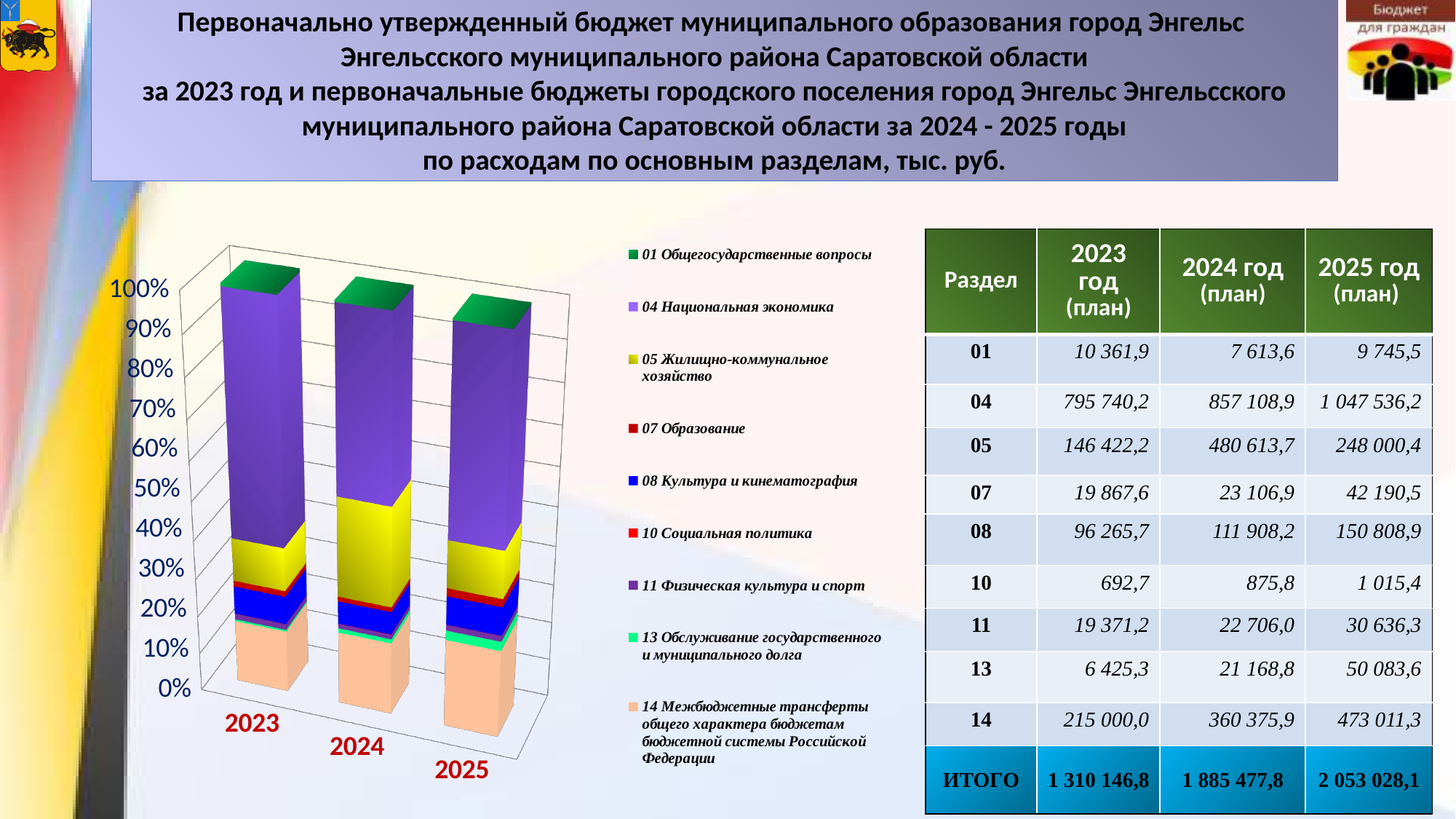
According to the table, which is larger: section 14 in 2024 or section 05 in 2024? section 05 in 2024 What kind of chart is shown on the left of the slide? stacked bar chart According to the table, which section has the lowest planned value in 2025? 10 According to the table, what is the planned value for section 05 in 2024? 480 613,7 How many series does the chart legend list? 9 Which legend entry is shown in yellow on the chart? 05 Жилищно-коммунальное хозяйство According to the table, what is the planned value for section 04 in 2025? 1 047 536,2 How many years (bars) are plotted on the chart? 3 What is the maximum value shown on the chart's vertical axis? 100% In the 2023 bar, is the top of the bottom (14 Межбюджетные трансферты) segment above or below 20%? below According to the table, what is the total (ИТОГО) for 2023? 1 310 146,8 Does the share of the bottom segment (14 Межбюджетные трансферты) rise or fall from 2023 to 2025? rise